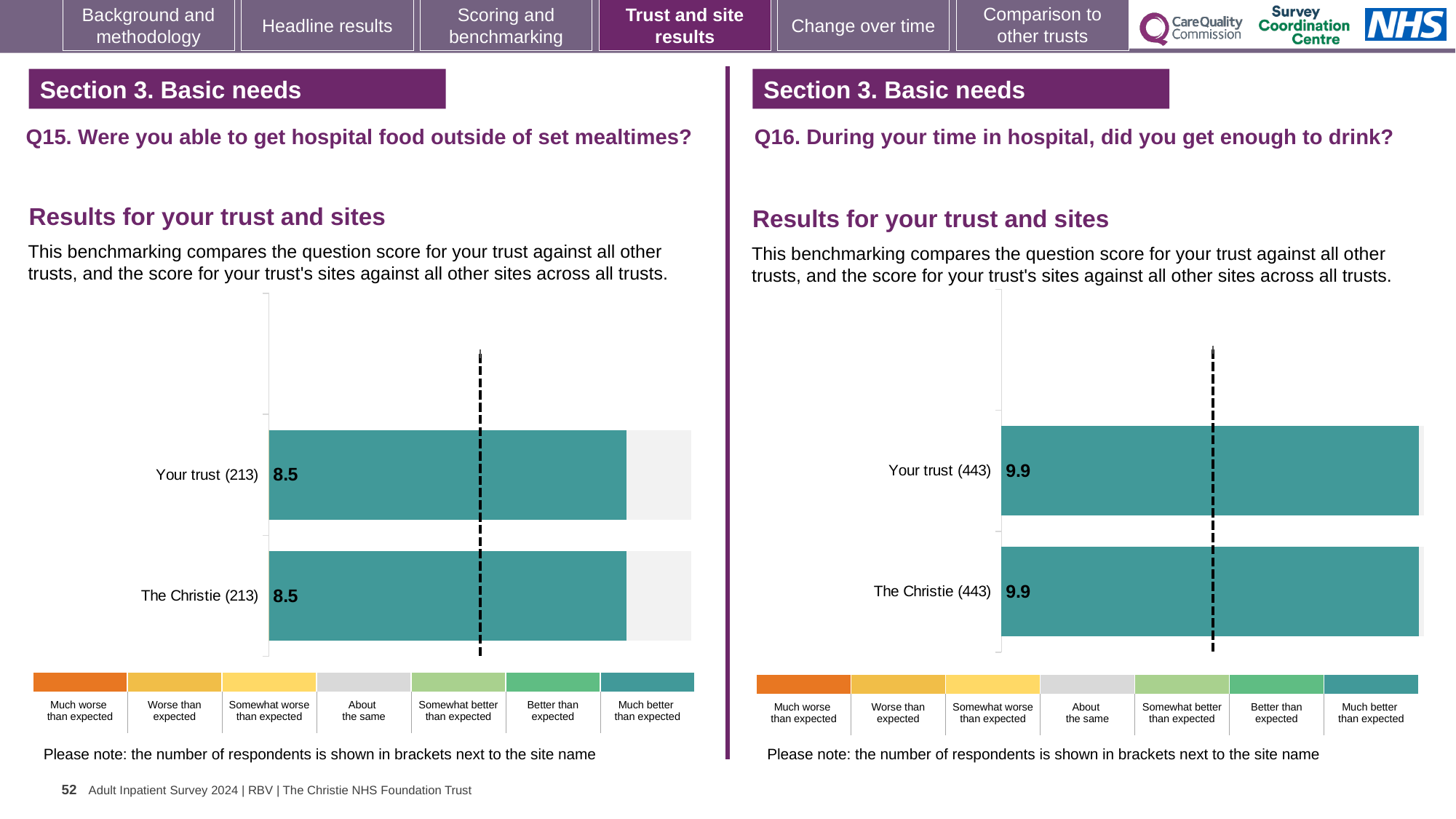
What type of chart is used in the Q15 chart (left)? Bar chart In the Q15 chart (left), what is the difference between the score for Your trust and the score for The Christie? 0 In the Q15 chart (left), what is the score for The Christie? 8.5 Is the Your trust score in the Q16 chart (right) larger than the Your trust score in the Q15 chart (left)? Yes In the Q16 chart (right), what is the score for The Christie? 9.9 In the Q16 chart (right), how many bars are plotted? 2 How many benchmark categories are listed in the colour key below the Q16 chart (right)? 7 In the Q15 chart (left), how many respondents are shown in brackets for Your trust? 213 In the Q15 chart (left), what is the score for Your trust? 8.5 In the Q16 chart (right), what is the score for Your trust? 9.9 In the Q16 chart (right), how many respondents are shown in brackets for The Christie? 443 In the Q15 chart (left), which benchmark category does the colour of the bars correspond to in the key below the chart? Much better than expected